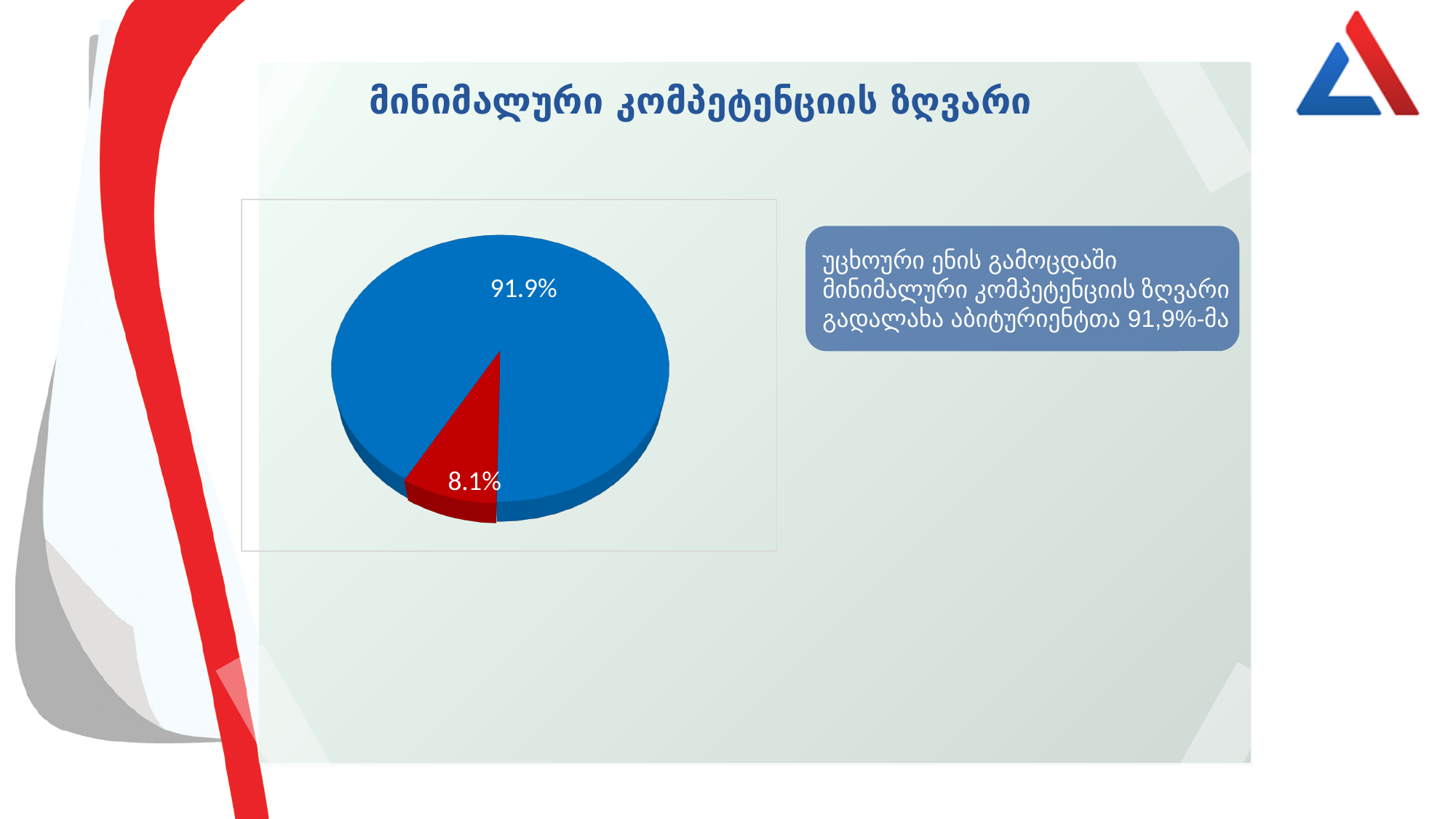
What is the difference between the blue slice value and the red slice value in the pie chart? 83.8 percentage points What value is shown on the red slice of the pie chart? 8.1% What colour is the largest slice of the pie chart? blue Which slice of the pie chart is the largest? the blue slice (91.9%) Which slice of the pie chart is the smallest? the red slice (8.1%) What value is shown on the blue slice of the pie chart? 91.9% Which is larger, the blue slice or the red slice of the pie chart? the blue slice What kind of chart is shown on the slide? pie chart What share of the pie does the red slice represent? 8.1% Does the pie chart have a legend? no How many slices does the pie chart have? 2 What share of the pie does the blue slice represent? 91.9%